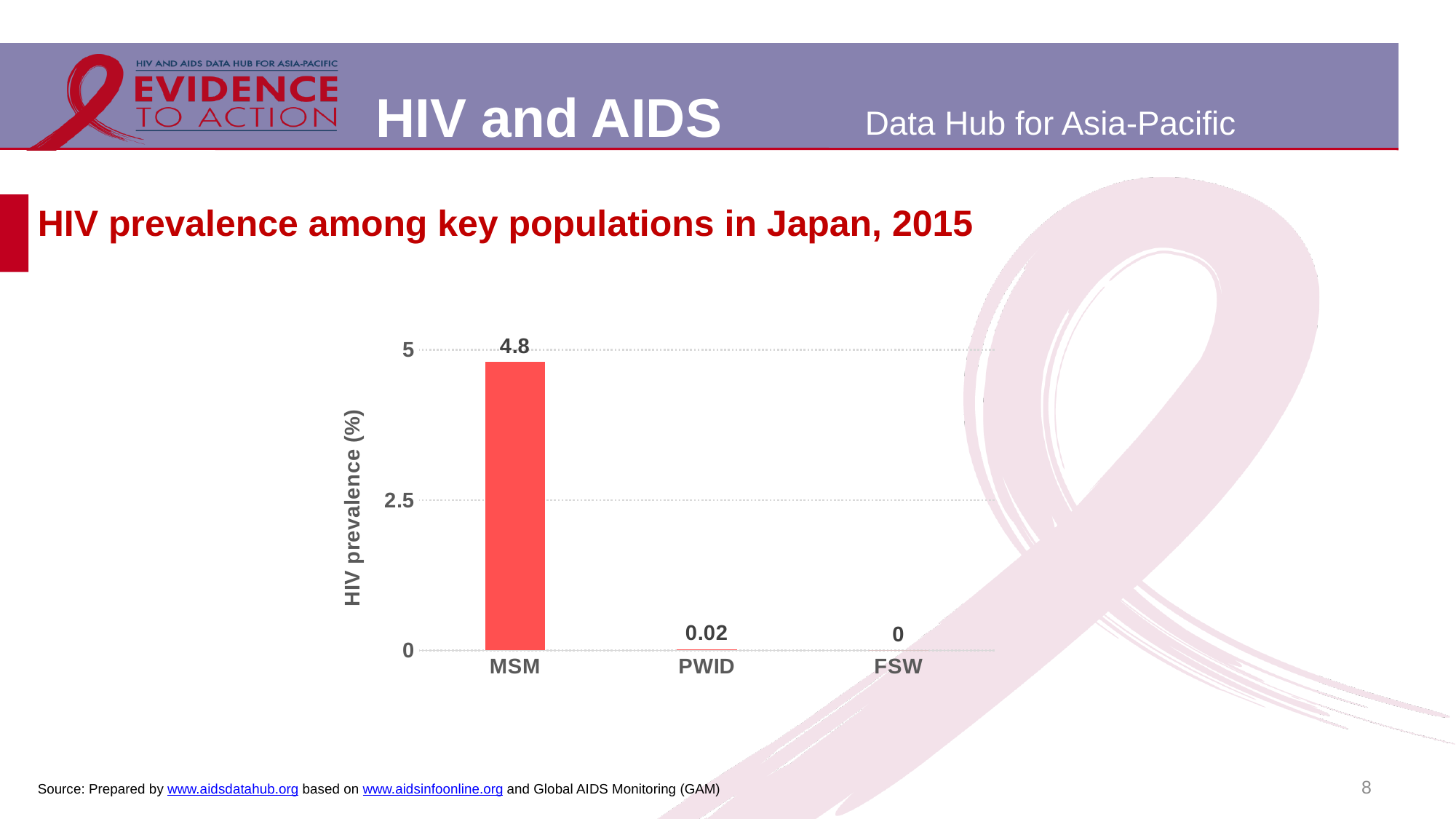
Is the HIV prevalence for MSM greater or less than 2.5? greater What is the HIV prevalence (%) for MSM? 4.8 What kind of chart is shown on the slide? bar chart Which key population has the highest HIV prevalence? MSM Which has a higher HIV prevalence, MSM or PWID? MSM How many key populations are shown on the chart? 3 What is the difference in HIV prevalence (%) between MSM and PWID? 4.78 What is the HIV prevalence (%) for PWID? 0.02 Which key population has the lowest HIV prevalence? FSW What is the HIV prevalence (%) for FSW? 0 What is the label of the vertical axis? HIV prevalence (%) What is the title of the chart? HIV prevalence among key populations in Japan, 2015